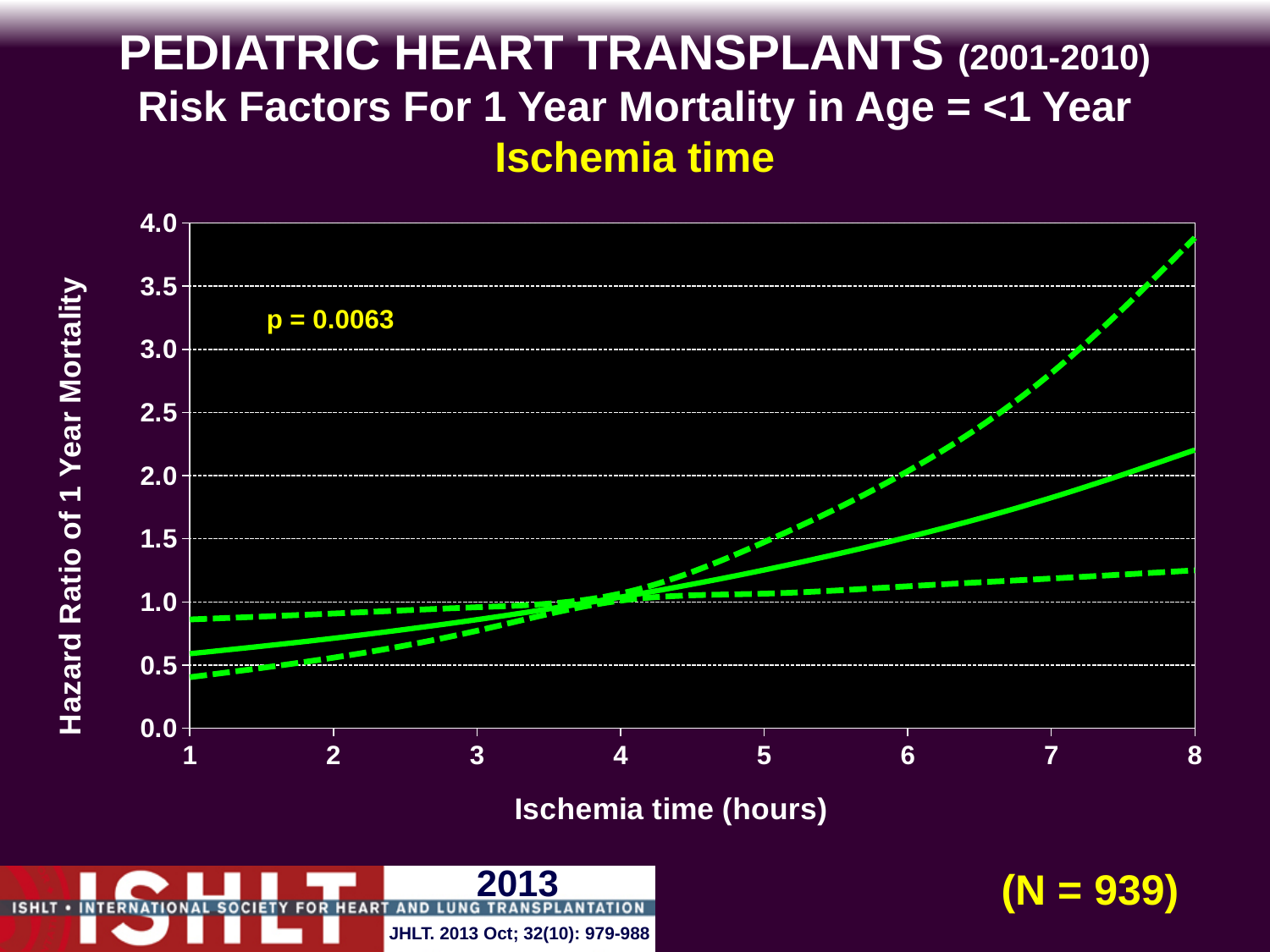
How many lines are plotted on the chart? 3 How many tick marks are labelled on the x axis of the chart? 8 Does the solid hazard ratio line rise or fall as ischemia time increases from 1 to 8 hours? rise Is the hazard ratio on the solid line at 1 hour of ischemia time greater or less than 1.0? less Is the hazard ratio on the solid line at 5 hours of ischemia time greater or less than 1.0? greater Is the lower dashed line at 8 hours of ischemia time greater or less than 1.5? less What p-value is printed on the chart? p = 0.0063 What is the label of the y axis of the chart? Hazard Ratio of 1 Year Mortality What kind of chart is shown on the slide? line chart